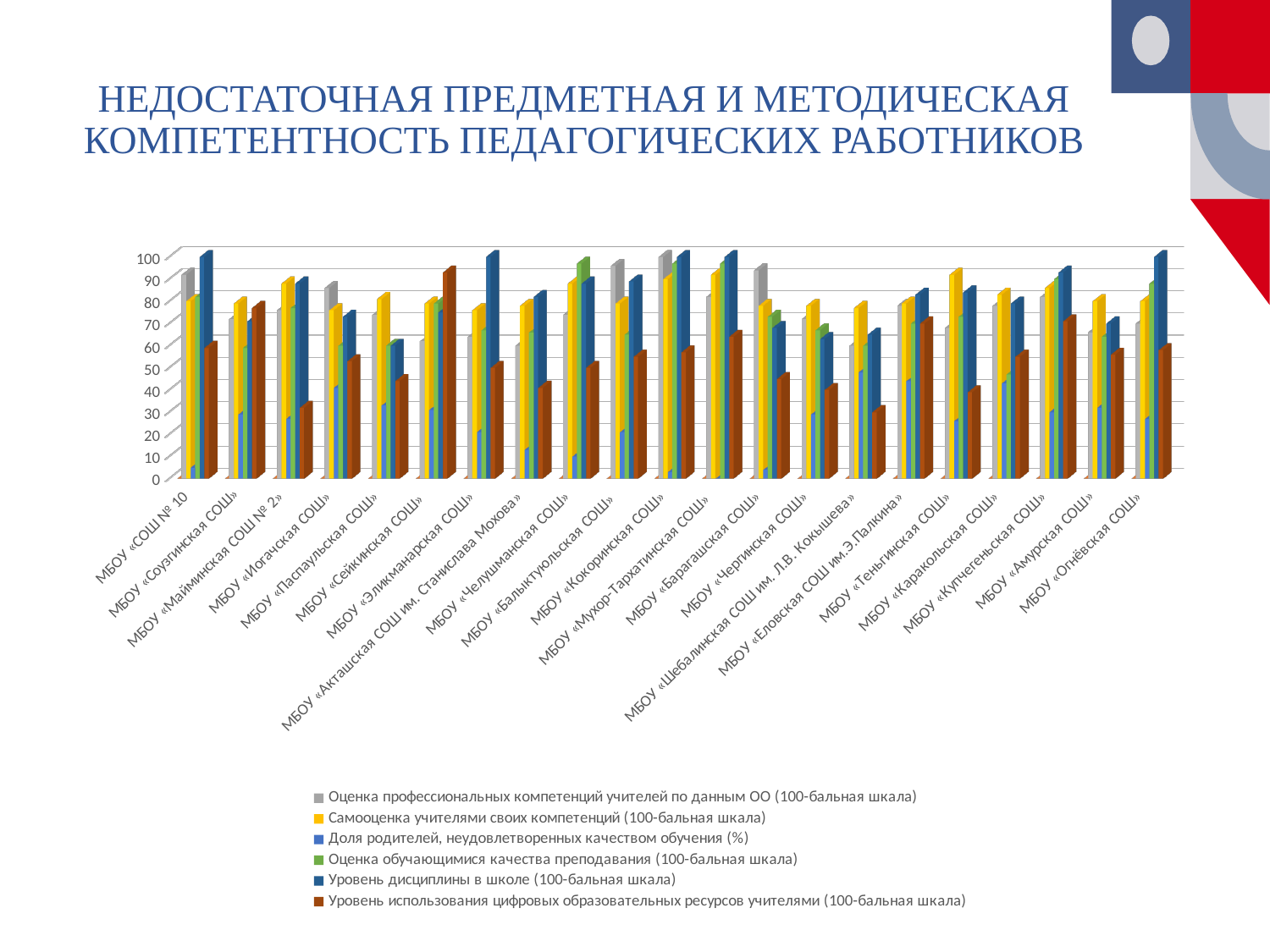
How many schools (categories) are shown along the x axis? 21 Is the value of «Уровень дисциплины в школе» for МБОУ «Акташская СОШ им. Станислава Мохова» greater or less than 90? less How many series does the legend list? 6 Is the value of «Самооценка учителями своих компетенций» for МБОУ «Мухор-Тархатинская СОШ» greater or less than 80? greater Is the value of «Оценка обучающимися качества преподавания» for МБОУ «Балыктуюльская СОШ» greater or less than 90? less Which colour represents the series «Самооценка учителями своих компетенций (100-бальная шкала)» in the legend? yellow What is the title of the slide above the chart? НЕДОСТАТОЧНАЯ ПРЕДМЕТНАЯ И МЕТОДИЧЕСКАЯ КОМПЕТЕНТНОСТЬ ПЕДАГОГИЧЕСКИХ РАБОТНИКОВ What kind of chart is shown on the slide? bar chart